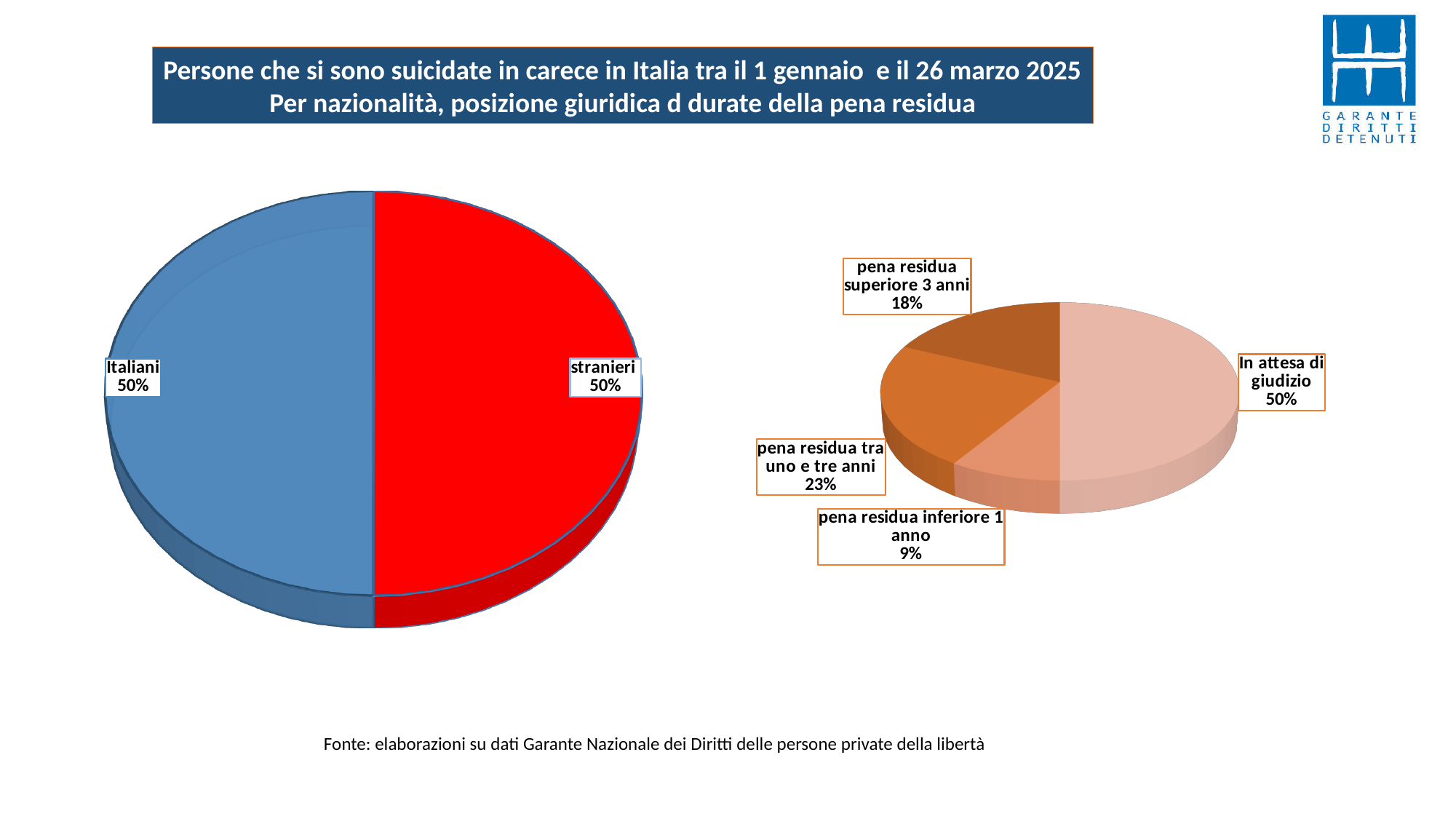
In the right pie chart, what share is labelled for 'In attesa di giudizio'? 50% In the left pie chart, what share is labelled for Italiani? 50% How many slices does the right pie chart have? 4 In the right pie chart, which category has the smallest share? pena residua inferiore 1 anno In the right pie chart, what share is labelled for 'pena residua tra uno e tre anni'? 23% What kind of chart is the chart on the left of the slide? Pie chart How many slices does the left pie chart have? 2 In the right pie chart, what share is labelled for 'pena residua superiore 3 anni'? 18% In the right pie chart, what share is labelled for 'pena residua inferiore 1 anno'? 9% In the right pie chart, which category has the largest share? In attesa di giudizio In the right pie chart, what is the difference in percentage points between 'pena residua tra uno e tre anni' and 'pena residua superiore 3 anni'? 5 percentage points In the left pie chart, what share is labelled for stranieri? 50%